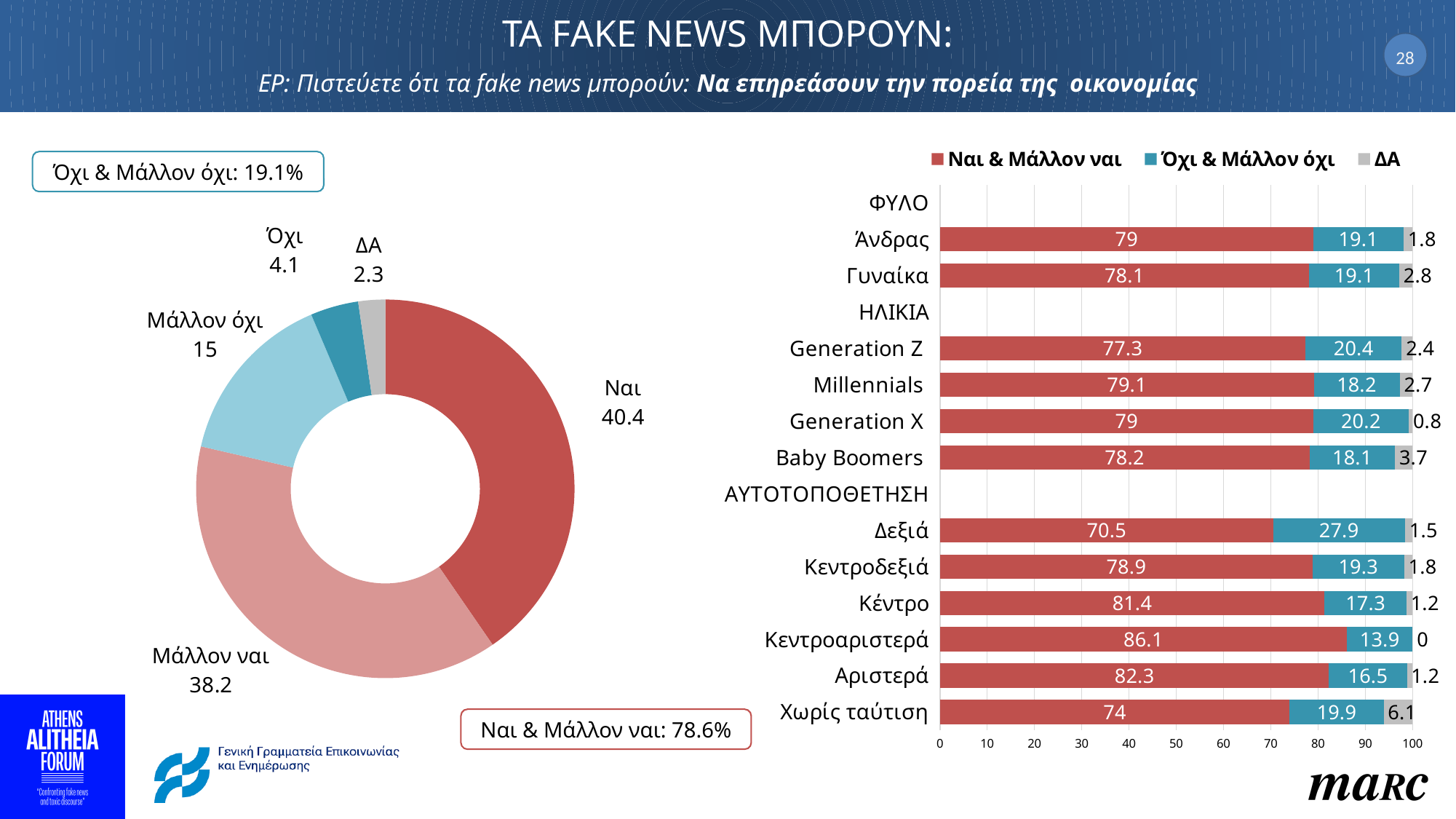
In the donut chart on the left, which category has the smallest slice? ΔΑ In the stacked bar chart on the right, what is the difference between the "Όχι & Μάλλον όχι" values for "Generation Z" and "Millennials"? 2.2 In the stacked bar chart on the right, which category has the lowest "Ναι & Μάλλον ναι" value? Δεξιά In the stacked bar chart on the right, what is the "ΔΑ" value for "Χωρίς ταύτιση"? 6.1 In the stacked bar chart on the right, which category has the highest "Όχι & Μάλλον όχι" value? Δεξιά In the donut chart on the left, what is the value for "Ναι"? 40.4 How many series does the legend of the stacked bar chart on the right list? 3 In the stacked bar chart on the right, which is larger: the "Ναι & Μάλλον ναι" value for "Κέντρο" or for "Αριστερά"? Αριστερά In the stacked bar chart on the right, what is the "Ναι & Μάλλον ναι" value for "Κεντροαριστερά"? 86.1 What kind of chart is on the left side of the slide? Donut (pie) chart In the donut chart on the left, what is the difference between "Ναι" and "Μάλλον ναι"? 2.2 In the donut chart on the left, how many categories are shown? 5